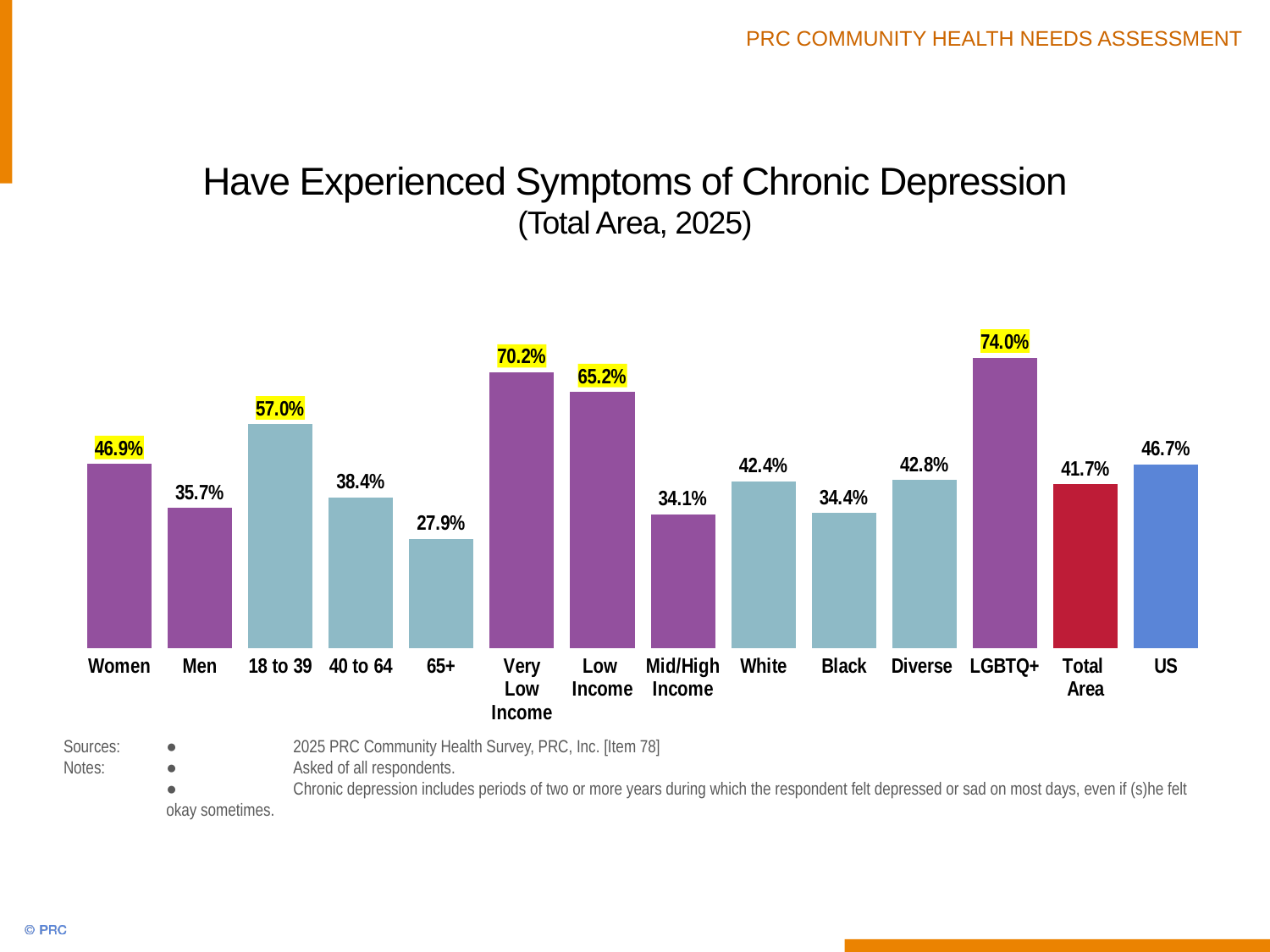
What kind of chart is shown on the slide? Bar chart What percentage of women have experienced symptoms of chronic depression? 46.9% How many categories are shown on the chart? 14 What is the value for the Total Area? 41.7% What is the value shown for the LGBTQ+ category? 74.0% Which is larger, the value for Total Area or the value for US? US What is the title of the chart? Have Experienced Symptoms of Chronic Depression (Total Area, 2025) Which is larger, the value for 18 to 39 or the value for 40 to 64? 18 to 39 What is the difference between the values for Women and Men? 11.2% Which category has the lowest value on the chart? 65+ What is the difference between the Very Low Income and Low Income values? 5.0% Which category has the highest value on the chart? LGBTQ+